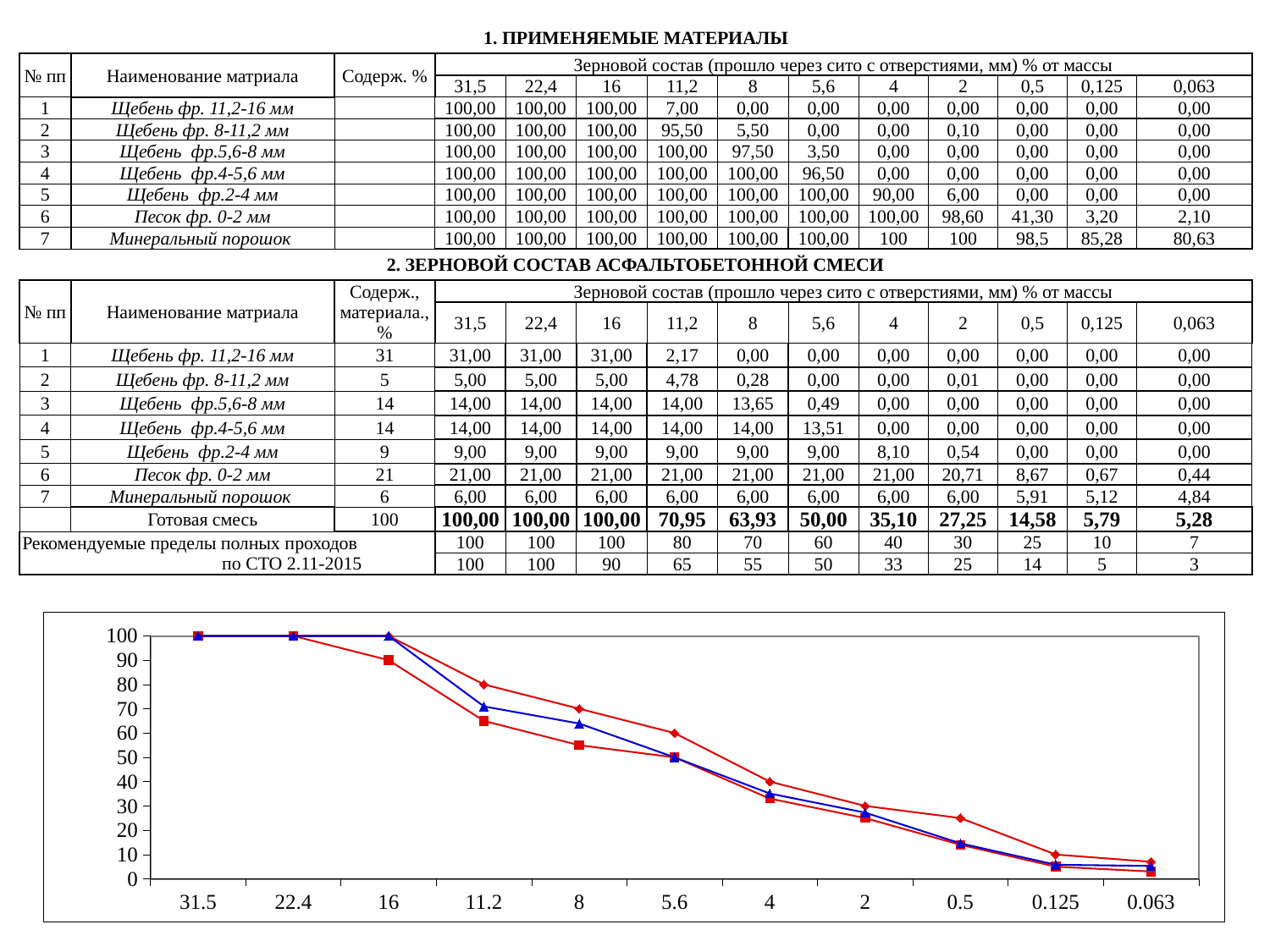
Is the value of the line with blue triangle markers at 11.2 greater or less than 60? greater At the x-axis category 0.5, which line is higher: the one with red diamond markers or the one with red square markers? red diamond markers Is the value of the line with blue triangle markers at 4 greater or less than 40? less What kind of chart is shown at the bottom of the slide? line chart How many categories are shown on the x axis of the chart? 11 Is the value of the line with red diamond markers at 8 greater or less than 60? greater What value do all three lines show at the x-axis category 31.5? 100 What value does the line with red square markers show at the x-axis category 16? 90 How many lines are plotted on the chart? 3 At which x-axis category do the lines reach their lowest values? 0.063 Do the plotted values rise or fall moving from left to right along the x axis of the chart? fall